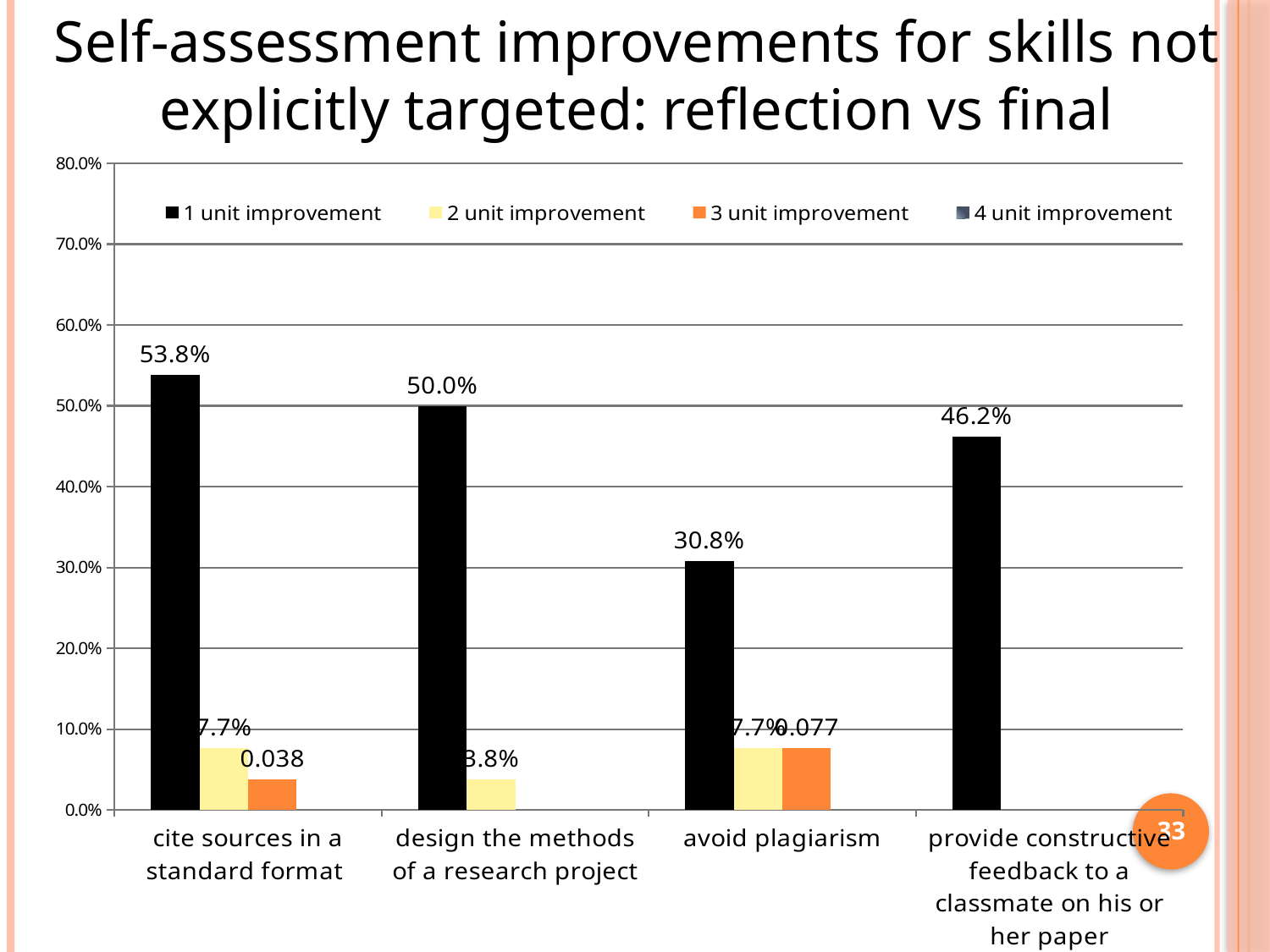
Which is larger: the 1 unit improvement value for "design the methods of a research project" or for "provide constructive feedback to a classmate on his or her paper"? design the methods of a research project How many series does the legend list? 4 What is the difference between the 1 unit improvement values for "cite sources in a standard format" and "design the methods of a research project"? 3.8% How many categories are shown on the x axis? 4 Which category has the lowest 1 unit improvement value? avoid plagiarism What is the 1 unit improvement value for "avoid plagiarism"? 30.8% Is the 1 unit improvement value for "avoid plagiarism" greater or less than 40.0%? less Which category has the highest 1 unit improvement value? cite sources in a standard format What is the 1 unit improvement value for "cite sources in a standard format"? 53.8% What is the 1 unit improvement value for "provide constructive feedback to a classmate on his or her paper"? 46.2% What is the 2 unit improvement value for "design the methods of a research project"? 3.8% What kind of chart is shown on the slide? bar chart